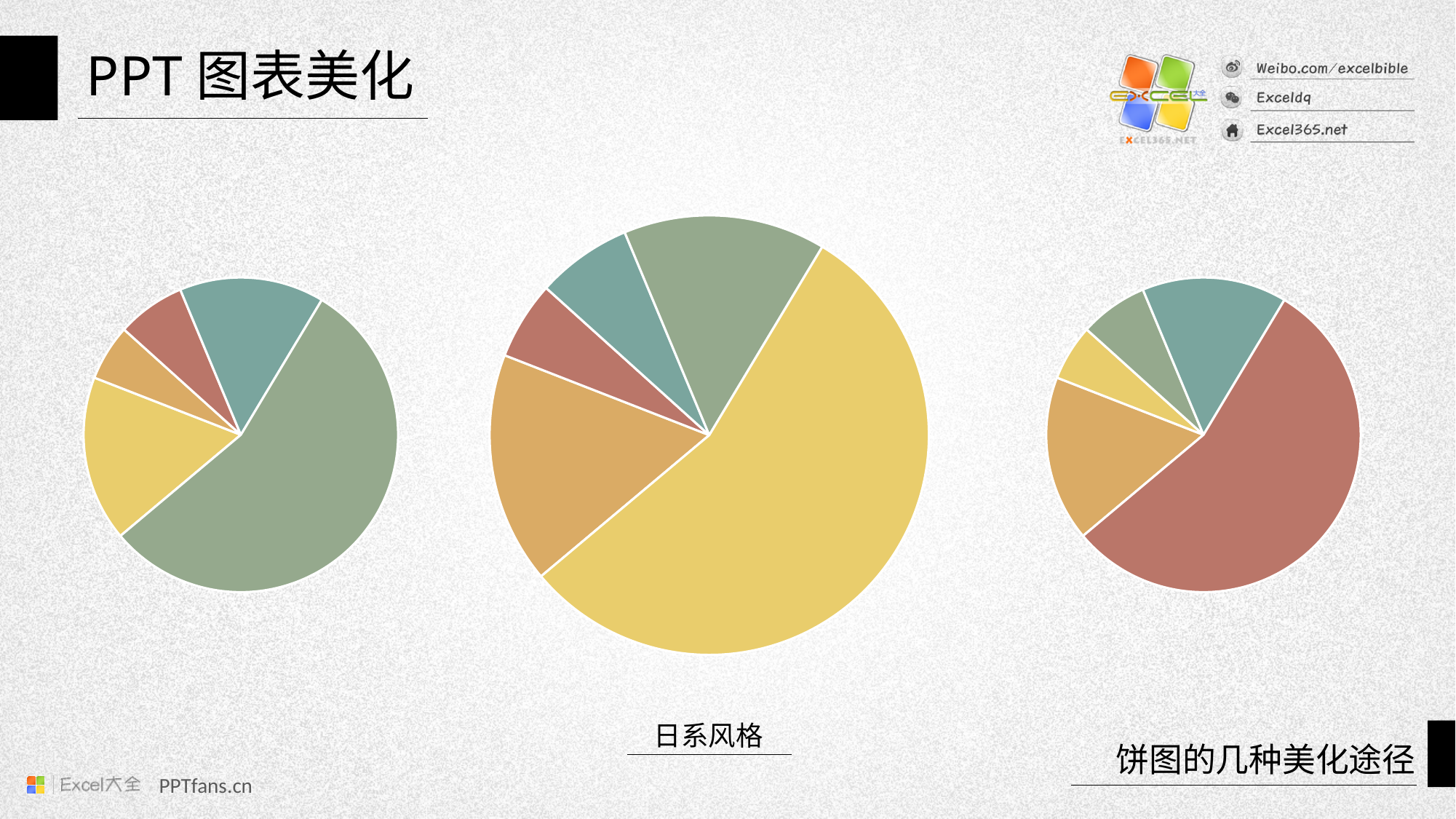
How many slices does the left pie chart have? 5 What is the caption printed below the middle pie chart? 日系风格 In the right pie chart, which colour slice is the largest? red What kind of chart is the large chart in the middle of the slide? pie chart In the middle pie chart, which colour slice is the largest? yellow How many slices does the right pie chart have? 5 What kind of chart is the chart on the left of the slide? pie chart In the left pie chart, which colour slice is the largest? green How many pie charts are shown on the slide? 3 How many slices does the middle pie chart have? 5